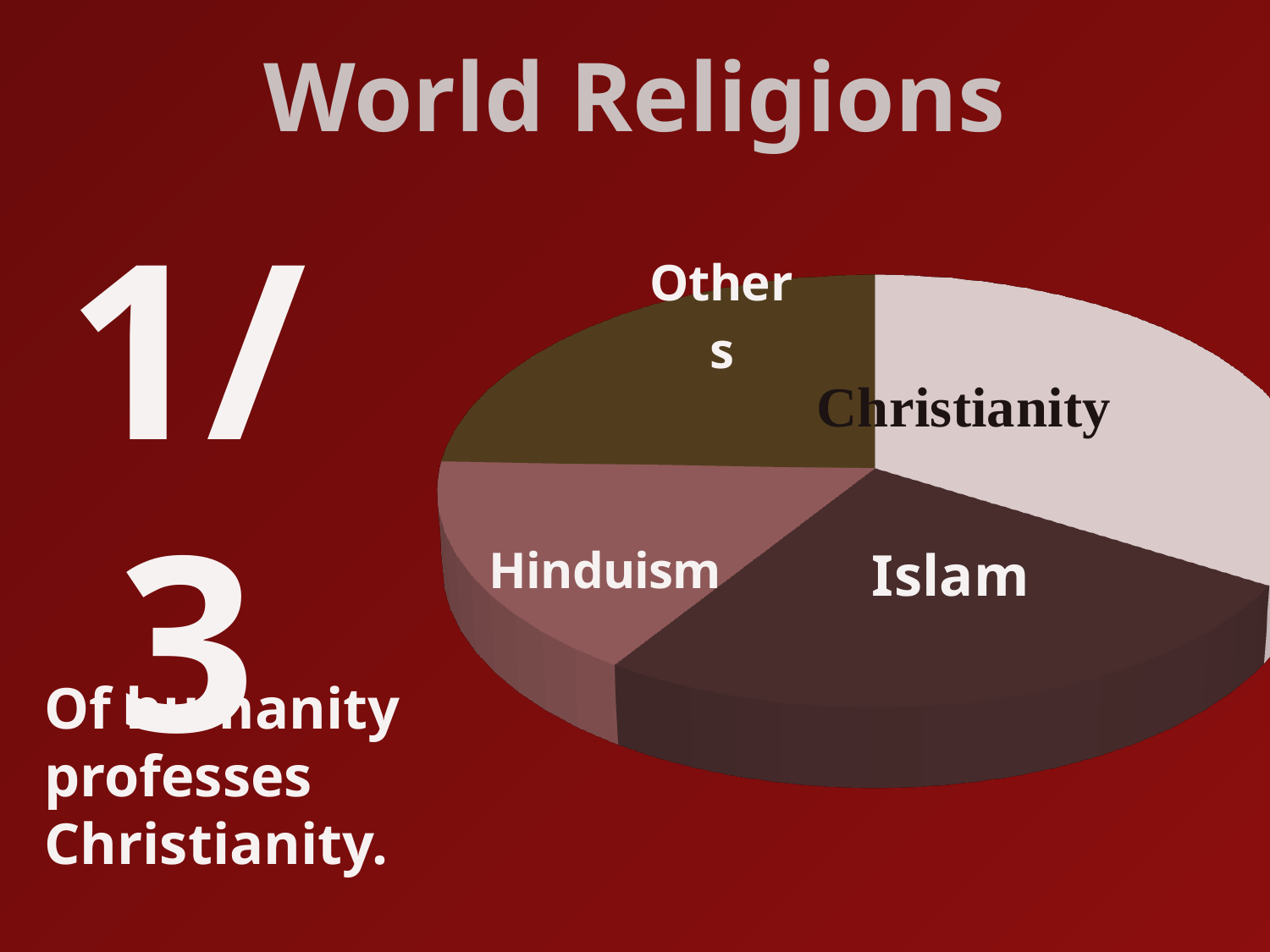
What kind of chart is shown on the slide? pie chart According to the text on the slide, what fraction of humanity professes Christianity? 1/3 Which slice is larger, Others or Hinduism? Others Which slice is larger, Christianity or Islam? Christianity What is the title of the slide containing the pie chart? World Religions Which religion has the largest slice in the pie chart? Christianity Which slice is larger, Islam or Hinduism? Islam How many slices does the pie chart have? 4 Which religion has the smallest slice in the pie chart? Hinduism